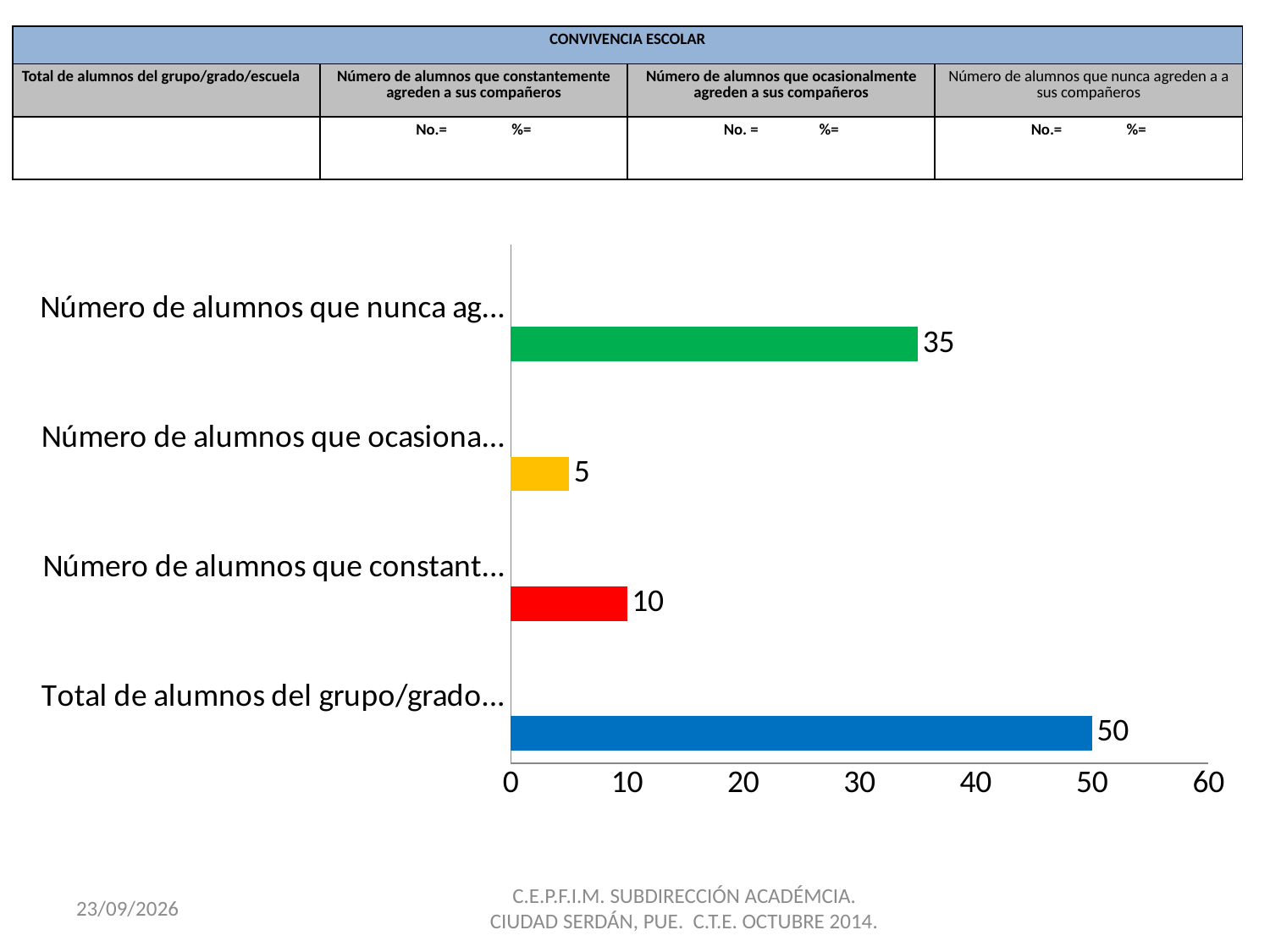
What is the value for 'Número de alumnos que nunca ag...'? 35 What is the difference between the values for 'Número de alumnos que nunca ag...' and 'Número de alumnos que constant...'? 25 Is the value for 'Número de alumnos que nunca ag...' greater or less than 40? less What is the value for 'Número de alumnos que ocasiona...'? 5 Which is larger, the value for 'Número de alumnos que constant...' or 'Número de alumnos que ocasiona...'? Número de alumnos que constant... What colour is the bar for 'Número de alumnos que constant...'? red What is the value for 'Total de alumnos del grupo/grado...'? 50 What kind of chart is shown on the slide? bar chart Which category has the lowest value? Número de alumnos que ocasiona... How many categories are shown in the chart? 4 Which category has the highest value? Total de alumnos del grupo/grado... What is the value for 'Número de alumnos que constant...'? 10